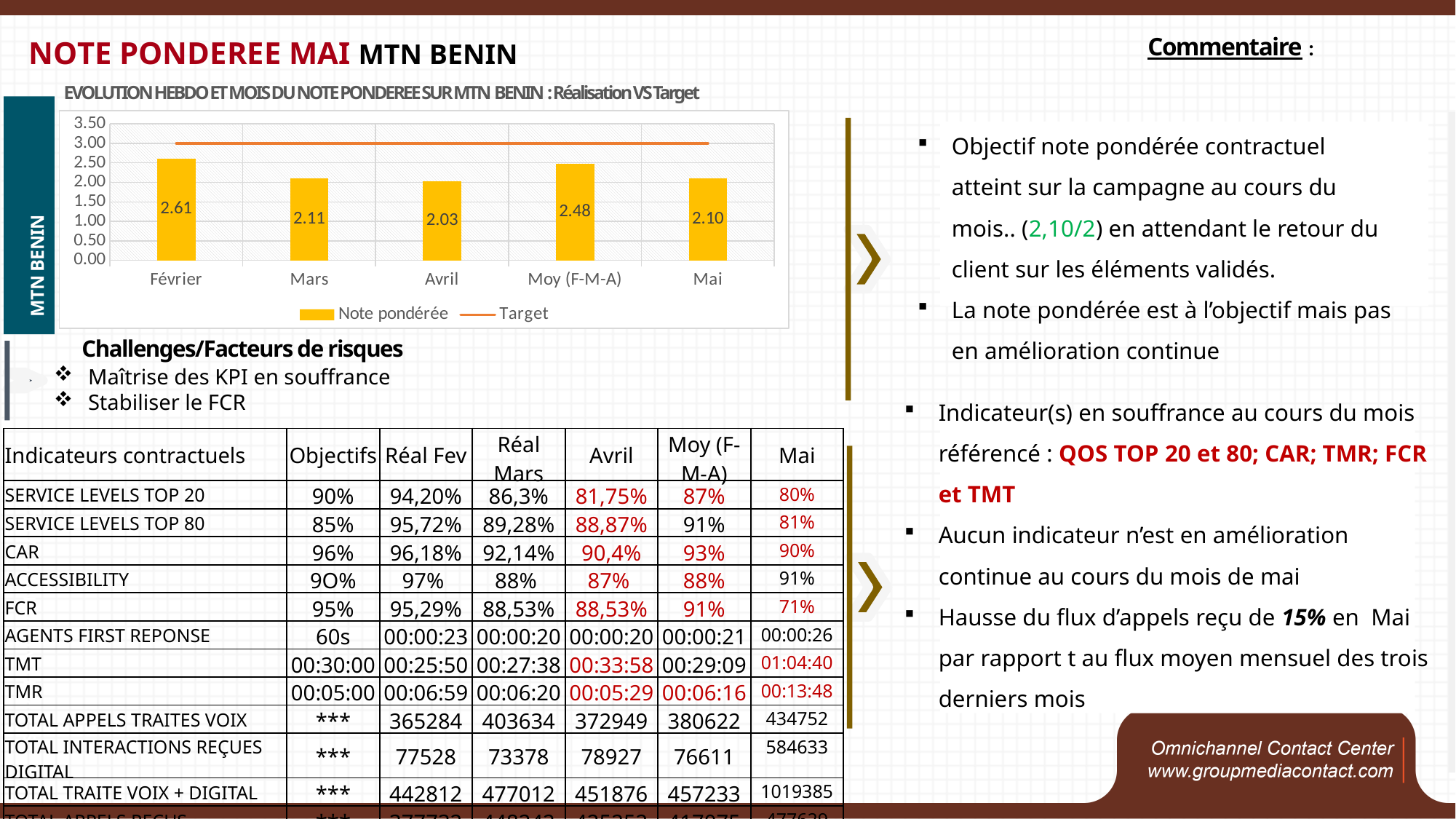
Is the Target line value greater or less than 2.50? greater Which category has the lowest Note pondérée? Avril What are the two entries in the chart legend? Note pondérée and Target What is the Note pondérée value for Mai? 2.10 Which is larger, the Note pondérée for Mars or for Moy (F-M-A)? Moy (F-M-A) What kind of chart is used to show the Note pondérée values? Bar chart Which category has the highest Note pondérée? Février What is the Note pondérée value for Moy (F-M-A)? 2.48 How many categories are shown on the x axis of the chart? 5 What is the Note pondérée value for Février? 2.61 What is the difference between the Note pondérée for Février and for Avril? 0.58 How many series does the chart legend list? 2